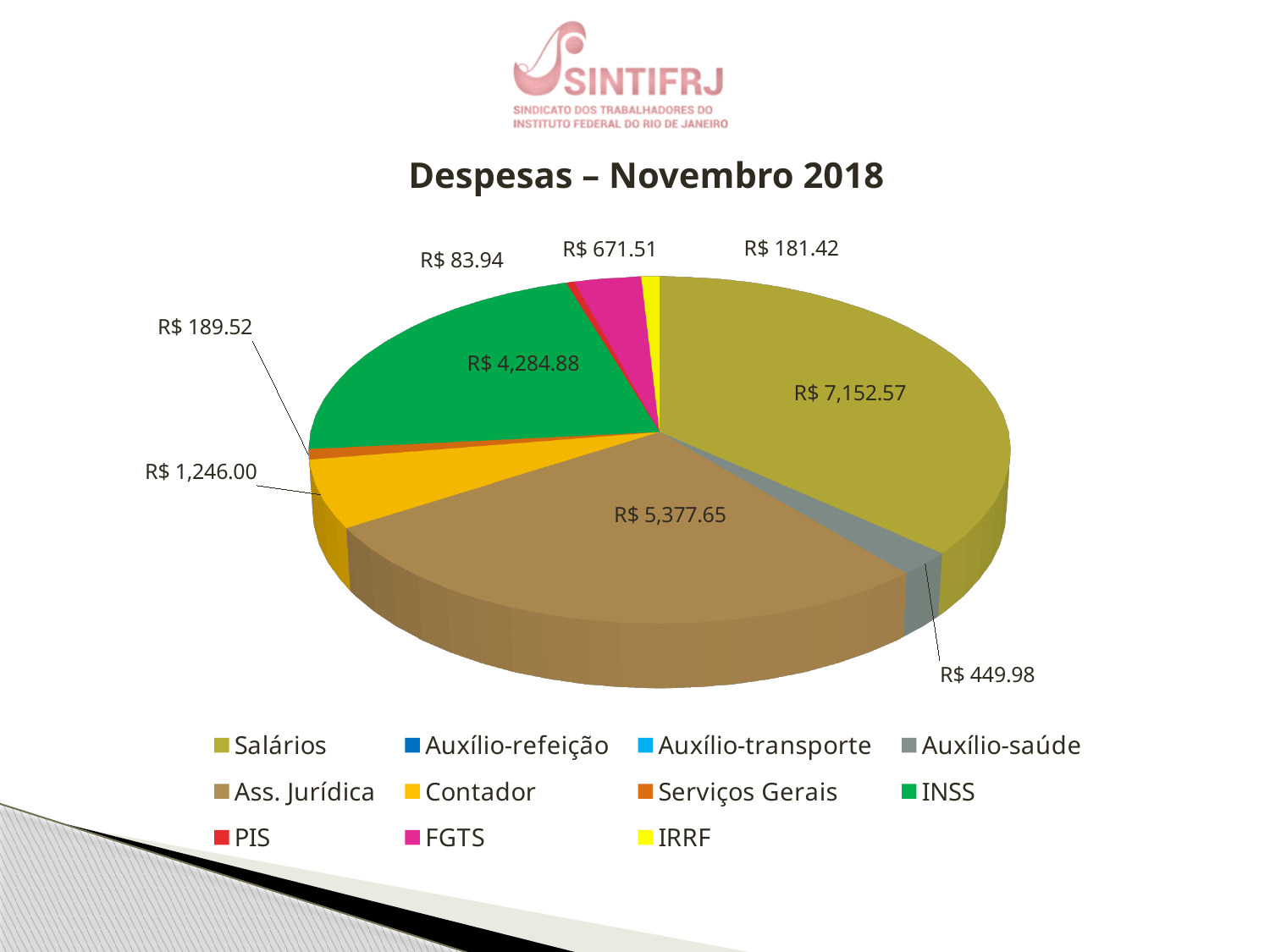
What is the value shown for Contador? R$ 1,246.00 What is the title of the chart? Despesas – Novembro 2018 What is the value shown for Salários? R$ 7,152.57 What is the value shown for FGTS? R$ 671.51 How many categories does the legend list? 11 What is the difference between the values for Salários and Ass. Jurídica? R$ 1,774.92 What is the value shown for Ass. Jurídica? R$ 5,377.65 Which category has the largest slice of the pie? Salários Which is larger, the value for INSS or the value for Ass. Jurídica? Ass. Jurídica What is the value shown for INSS? R$ 4,284.88 What kind of chart is shown on the slide? Pie chart Which labeled slice has the smallest value? PIS